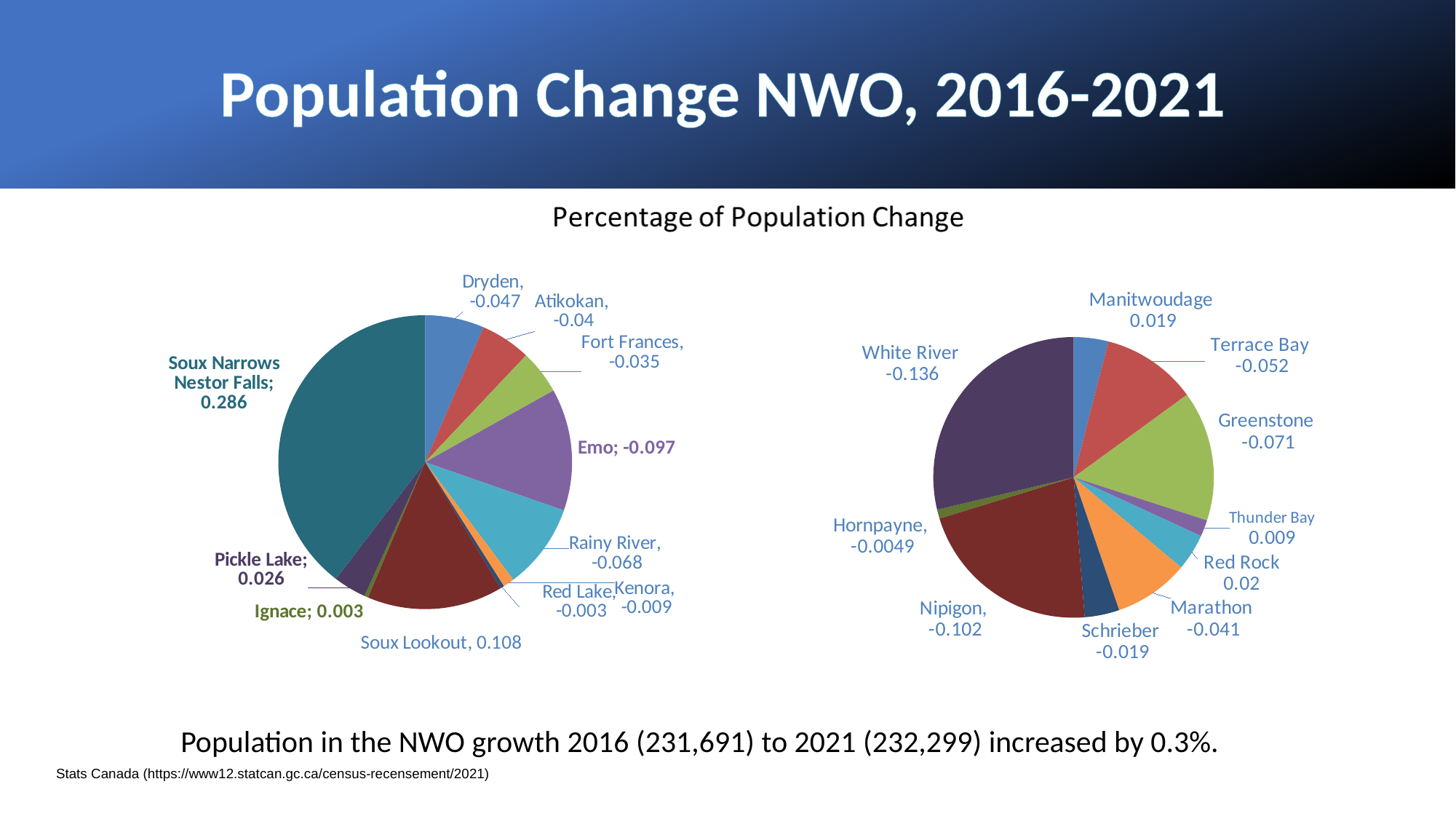
What type of chart is used on this slide? Pie chart On the left pie chart, what is the difference between the values for Soux Lookout and Pickle Lake? 0.082 On the right pie chart, which community has the lowest value? White River On the left pie chart, what is the value for Emo? -0.097 How many communities are shown on the left pie chart? 11 On the left pie chart, which is larger, the value for Dryden or the value for Atikokan? Atikokan On the right pie chart, what is the value for Nipigon? -0.102 How many communities are shown on the right pie chart? 10 On the right pie chart, which is larger, the value for Nipigon or the value for White River? Nipigon On the right pie chart, what is the value for White River? -0.136 On the left pie chart, which community has the highest value? Soux Narrows Nestor Falls On the left pie chart, what is the value for Soux Narrows Nestor Falls? 0.286